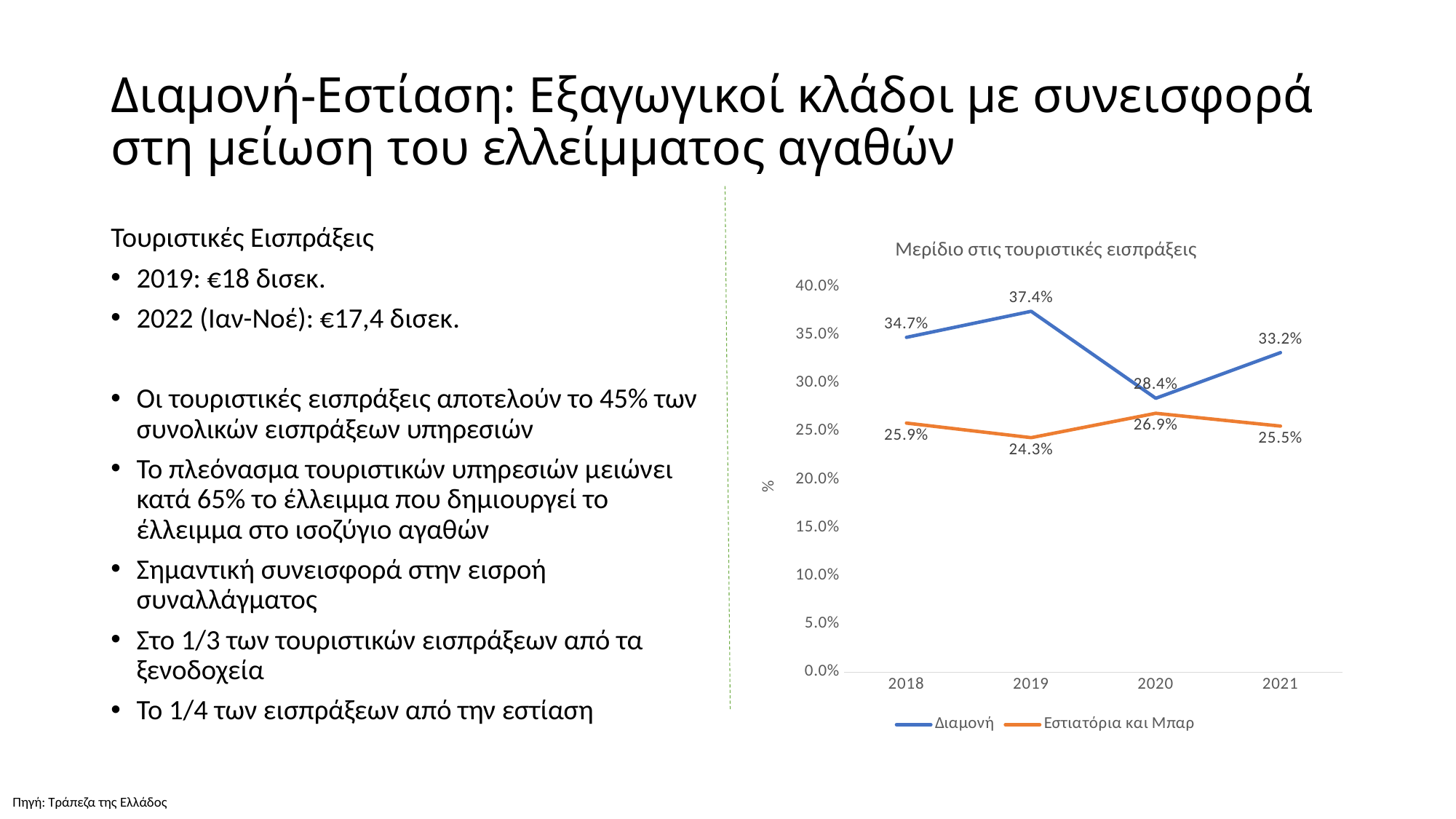
How many years are shown on the x axis? 4 How many series does the legend list? 2 In which year is the Διαμονή series at its lowest? 2020 What is the title of the chart? Μερίδιο στις τουριστικές εισπράξεις Which series has the larger value in 2018, Διαμονή or Εστιατόρια και Μπαρ? Διαμονή What is the value for Εστιατόρια και Μπαρ in 2020? 26.9% What kind of chart is shown on the slide? line chart Does the Διαμονή series rise or fall from 2019 to 2020? fall In which year is the Εστιατόρια και Μπαρ series at its highest? 2020 What is the difference between Διαμονή and Εστιατόρια και Μπαρ in 2019? 13.1% What is the value for Διαμονή in 2021? 33.2% What is the value for Διαμονή in 2019? 37.4%